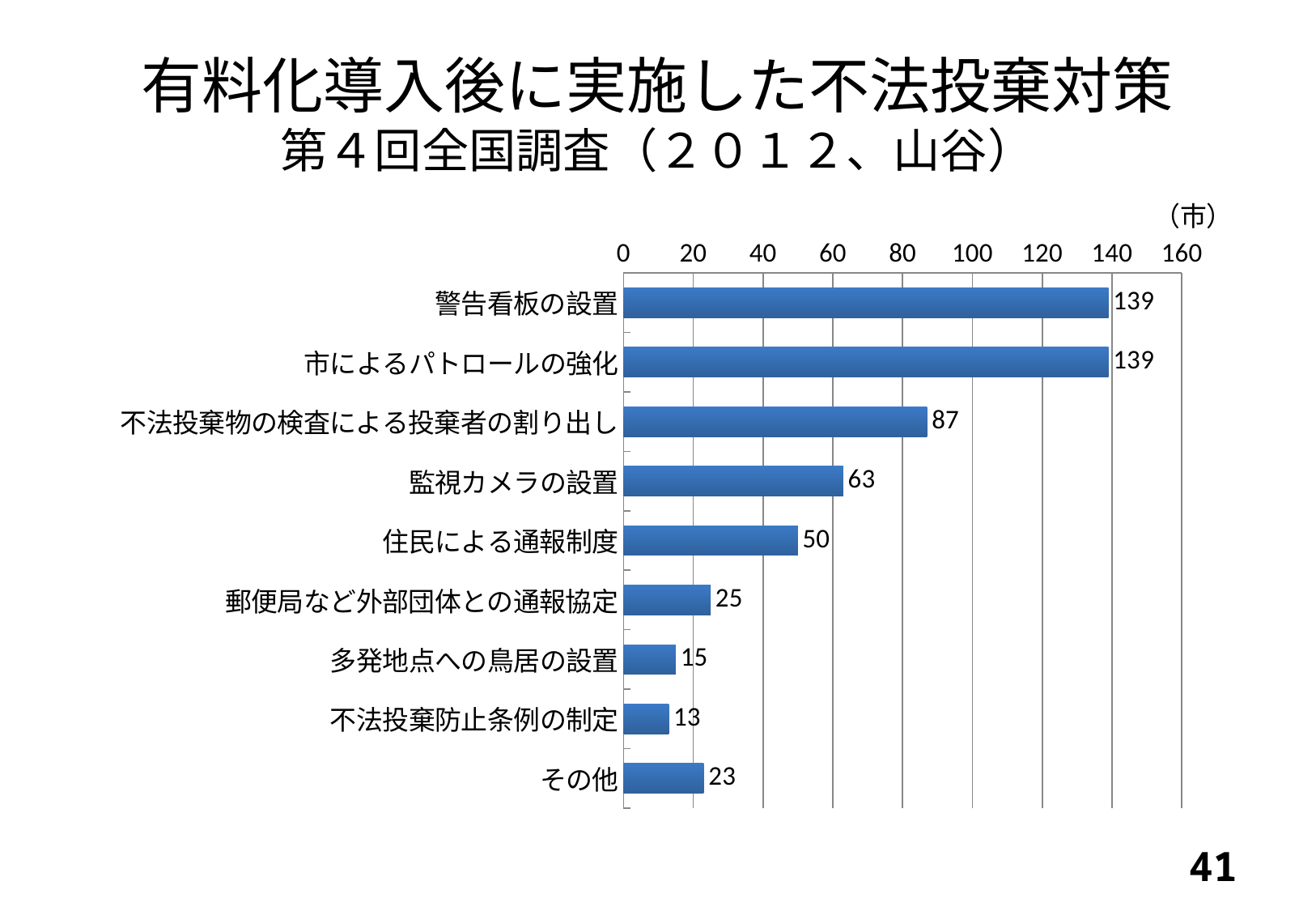
Is the value for 市によるパトロールの強化 greater or less than 120? greater What is the value for 不法投棄物の検査による投棄者の割り出し? 87 What kind of chart is shown on the slide? bar chart What unit is indicated above the axis of the chart? （市） How many categories are shown in the chart? 9 What is the difference between the values for 監視カメラの設置 and 住民による通報制度? 13 Which category has the lowest value? 不法投棄防止条例の制定 What is the value for その他? 23 What is the difference between the values for 警告看板の設置 and 不法投棄物の検査による投棄者の割り出し? 52 What is the value for 住民による通報制度? 50 What is the value for 監視カメラの設置? 63 Which is larger, the value for 郵便局など外部団体との通報協定 or the value for その他? 郵便局など外部団体との通報協定